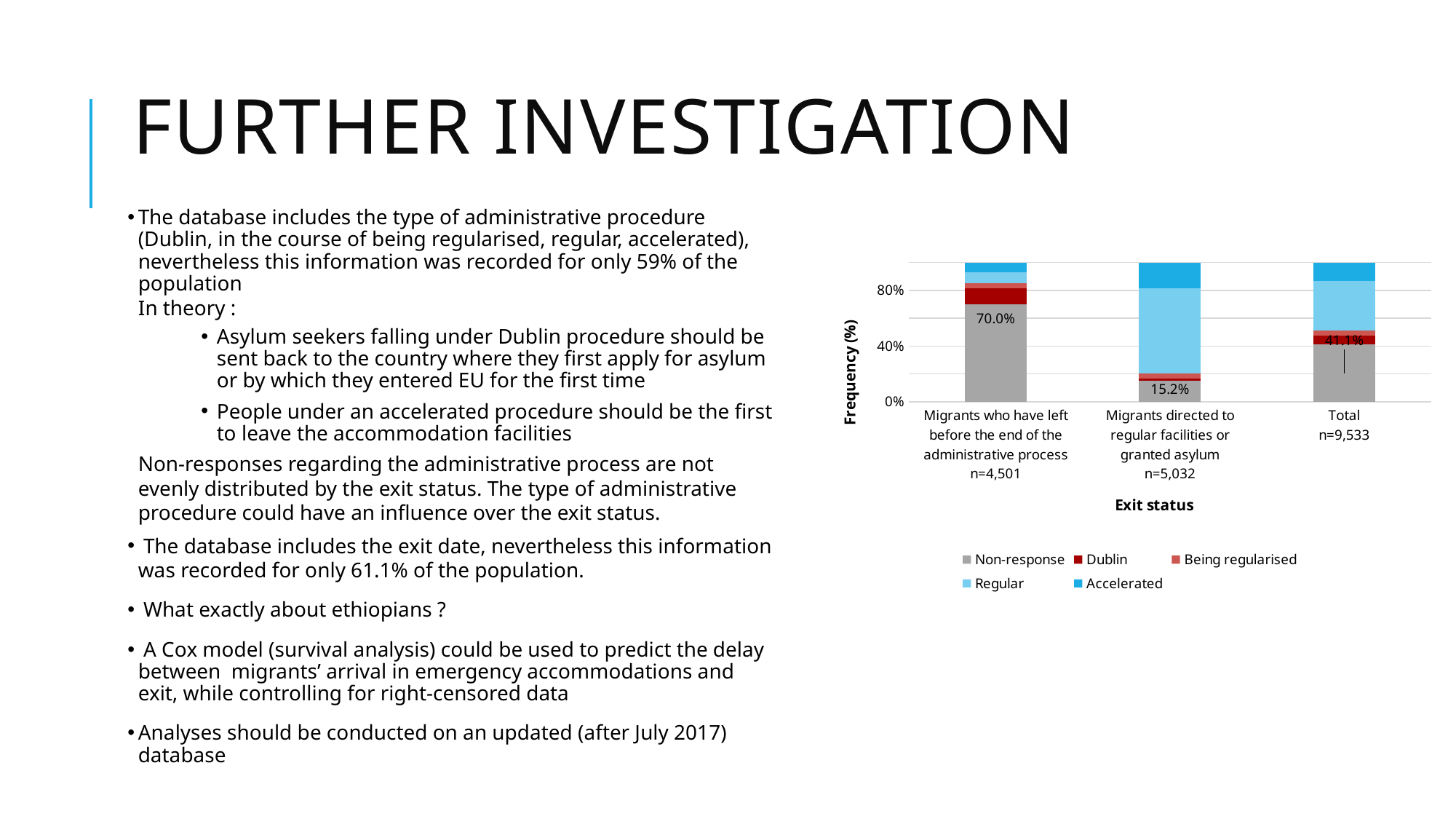
Which category has the lowest Non-response share? Migrants directed to regular facilities or granted asylum What is the Non-response value for migrants who have left before the end of the administrative process? 70.0% Which category has the highest Non-response share? Migrants who have left before the end of the administrative process What is the Non-response value for the Total category? 41.1% How many series does the chart legend list? 5 How many exit status categories are shown on the x axis of the chart? 3 Is the Non-response share for the Total category larger or smaller than for migrants directed to regular facilities or granted asylum? larger What is the Non-response value for migrants directed to regular facilities or granted asylum? 15.2% What is the sample size (n) shown for the Total category? n=9,533 What kind of chart is shown on the slide? stacked bar chart What is the label of the y axis of the chart? Frequency (%) What is the difference between the Non-response share for migrants who have left before the end of the administrative process and for migrants directed to regular facilities or granted asylum? 54.8%